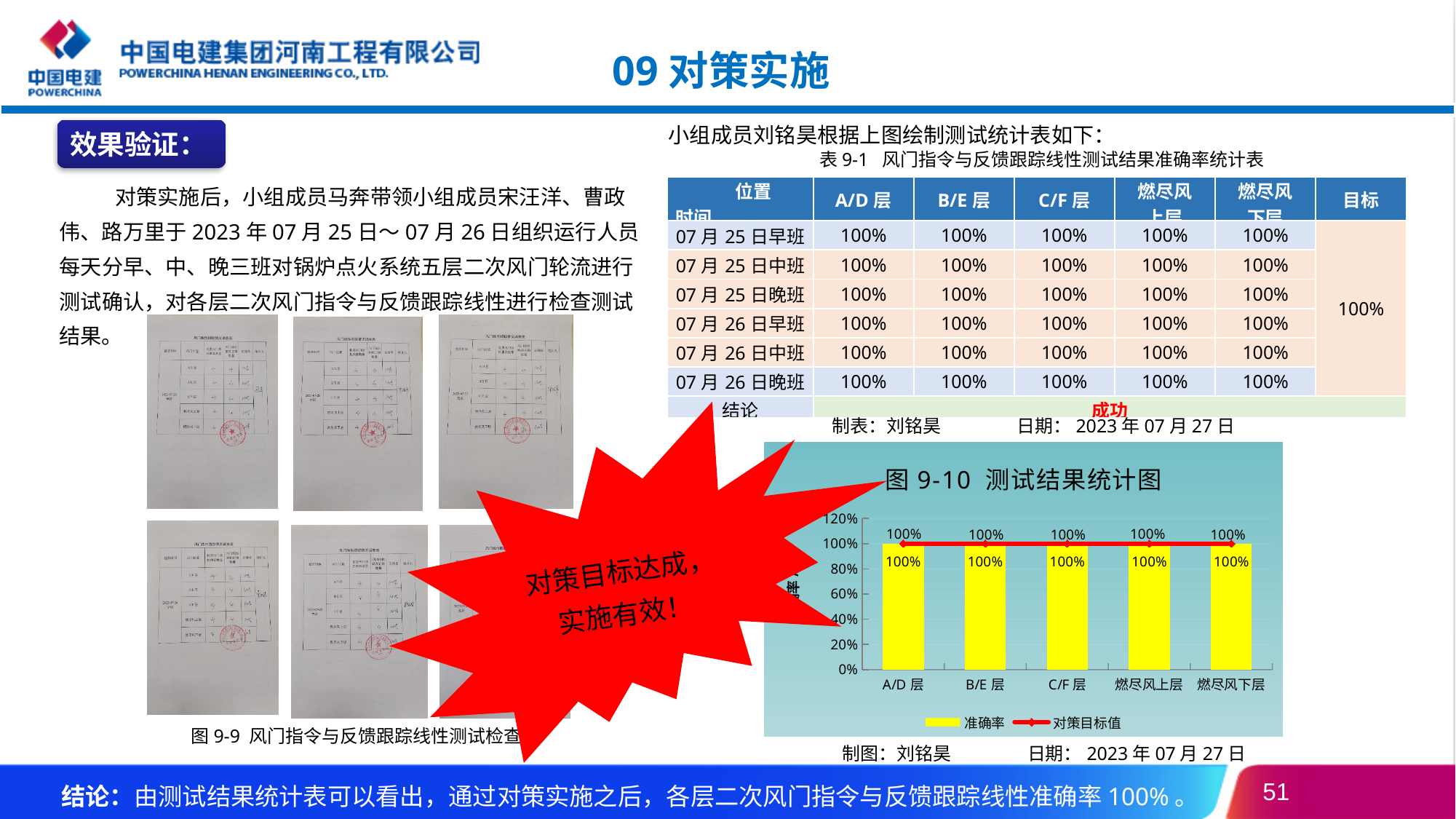
How many series does the legend of the chart 图 9-10 测试结果统计图 list? 2 What is the 准确率 value for 燃尽风上层 in the chart 图 9-10 测试结果统计图? 100% What is the 对策目标值 shown for C/F 层 in the chart 图 9-10 测试结果统计图? 100% What is the 准确率 value for A/D 层 in the chart 图 9-10 测试结果统计图? 100% In the chart 图 9-10 测试结果统计图, what is the difference between the 准确率 for A/D 层 and the 准确率 for C/F 层? 0% What is the 准确率 value for 燃尽风下层 in the chart 图 9-10 测试结果统计图? 100% In the chart 图 9-10 测试结果统计图, is the 准确率 value for B/E 层 greater or less than 80%? greater What kind of chart is 图 9-10 测试结果统计图? Bar chart with a line series How many categories are shown on the x axis of the chart 图 9-10 测试结果统计图? 5 In the chart 图 9-10 测试结果统计图, do the 准确率 values rise, fall, or stay flat across the categories from A/D 层 to 燃尽风下层? Stay flat What is the title of the chart on the lower right of the slide? 图 9-10 测试结果统计图 In the chart 图 9-10 测试结果统计图, what colour are the 准确率 bars? Yellow